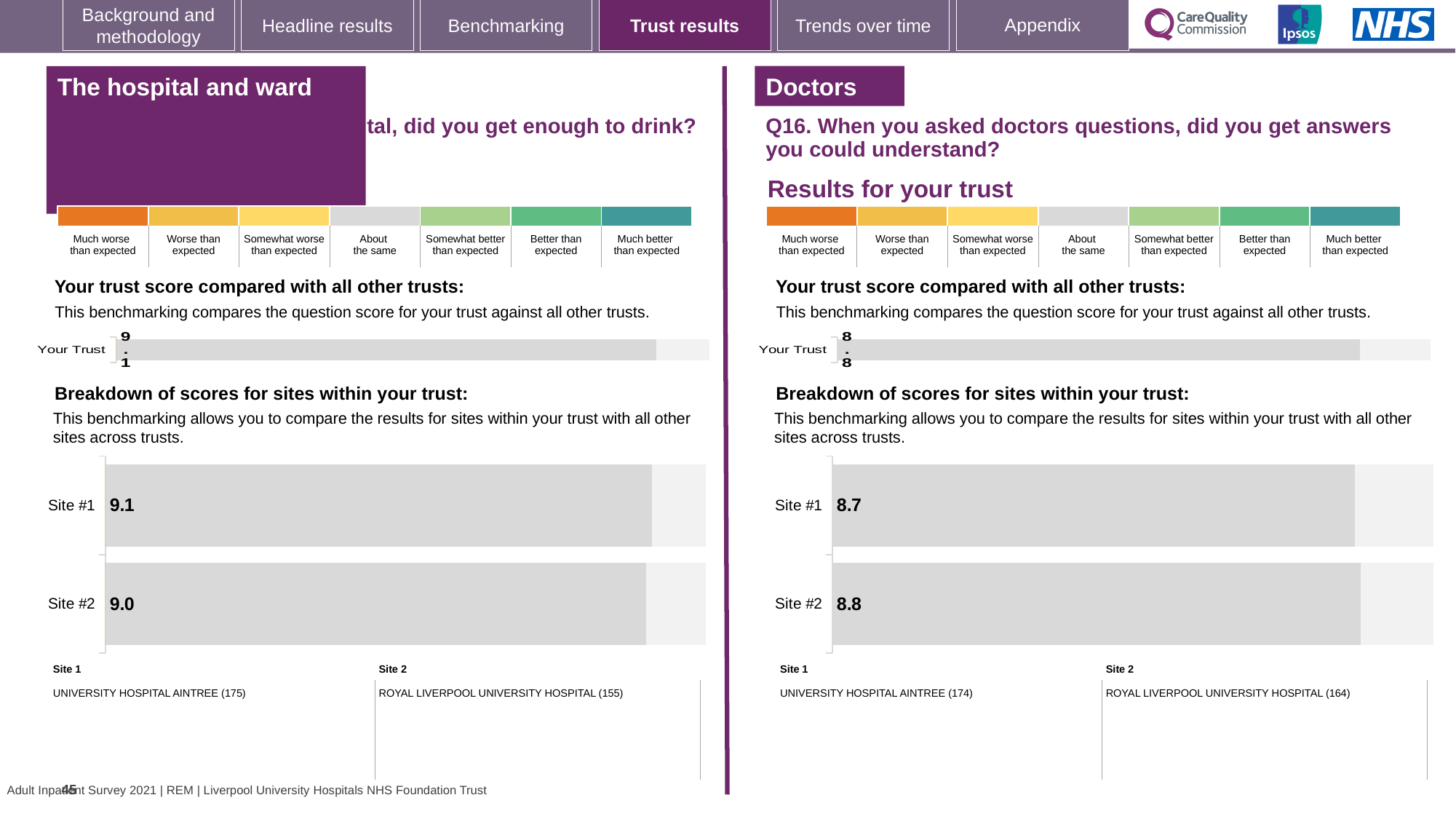
In the site breakdown chart on the left side of the slide (The hospital and ward section), what is the score for Site #1? 9.1 In the site breakdown chart for Q16 on the right side of the slide, what is the score for Site #2? 8.8 In the site breakdown chart for Q16 on the right side of the slide, what is the score for Site #1? 8.7 In the site breakdown chart for Q16 on the right side of the slide, what is the difference between the Site #2 and Site #1 scores? 0.1 In the site breakdown chart on the left side of the slide (The hospital and ward section), what is the score for Site #2? 9.0 In the site breakdown chart on the left side of the slide (The hospital and ward section), what is the difference between the Site #1 and Site #2 scores? 0.1 In the site breakdown chart on the left side of the slide (The hospital and ward section), which site has the lower score? Site #2 In the 'Your trust score compared with all other trusts' chart for Q16 on the right side of the slide, what is the score for Your Trust? 8.8 How many sites are shown in the site breakdown chart for Q16 on the right side of the slide? 2 What type of chart is used for the site breakdown on the left side of the slide? Bar chart In the 'Your trust score compared with all other trusts' chart on the left side of the slide, what is the score for Your Trust? 9.1 In the site breakdown chart for Q16 on the right side of the slide, which site has the higher score? Site #2